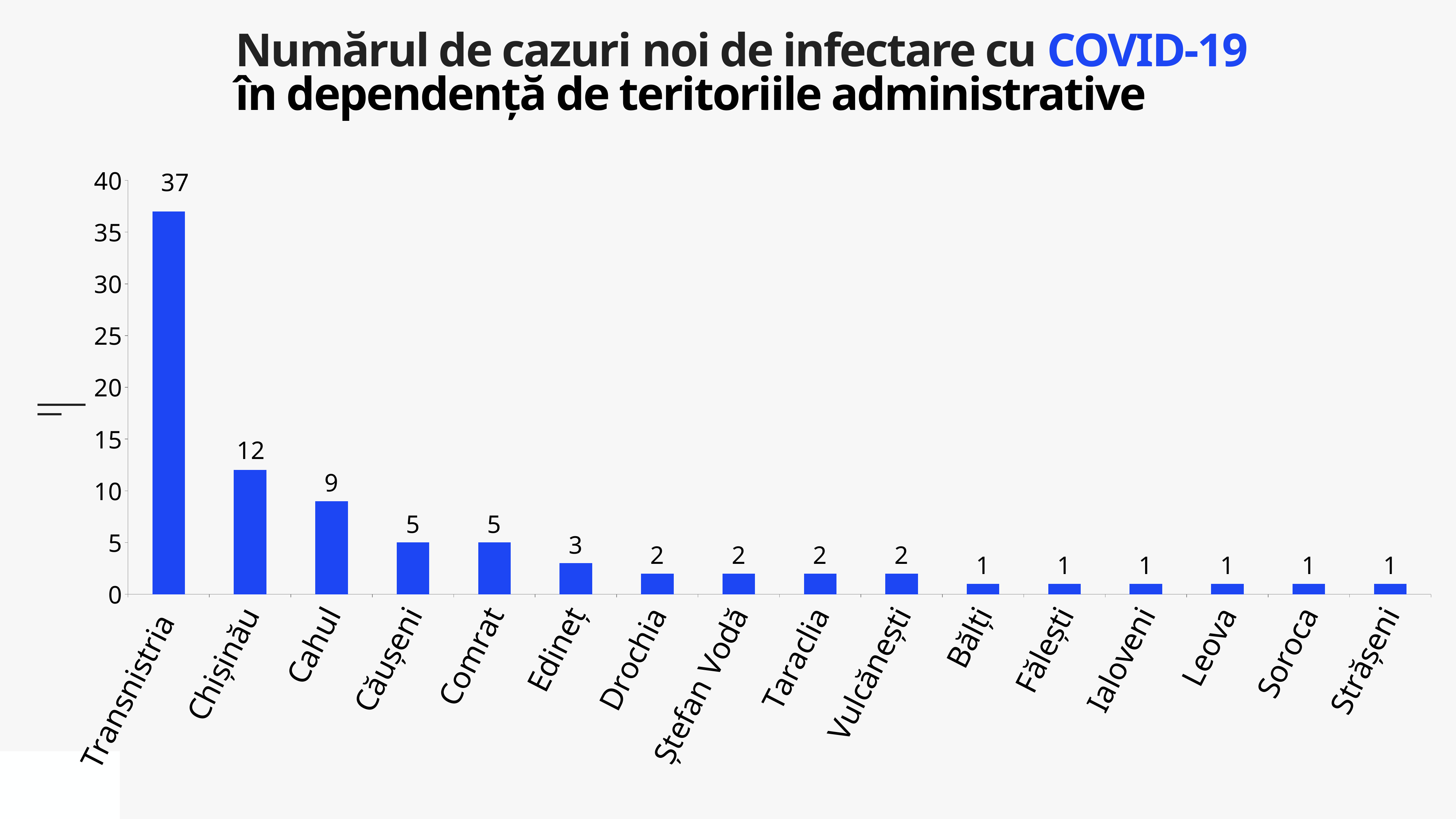
Is the value for Transnistria greater or less than 35? greater How many categories are shown on the x axis? 16 What is the value for Chișinău? 12 What is the value for Transnistria? 37 What is the difference between the values for Transnistria and Chișinău? 25 Do the values rise or fall from left to right along the x axis? fall Which is larger, the value for Comrat or the value for Drochia? Comrat What kind of chart is shown on the slide? bar chart What is the value for Edineț? 3 Which category has the highest value? Transnistria What is the difference between the values for Cahul and Căușeni? 4 What is the value for Cahul? 9